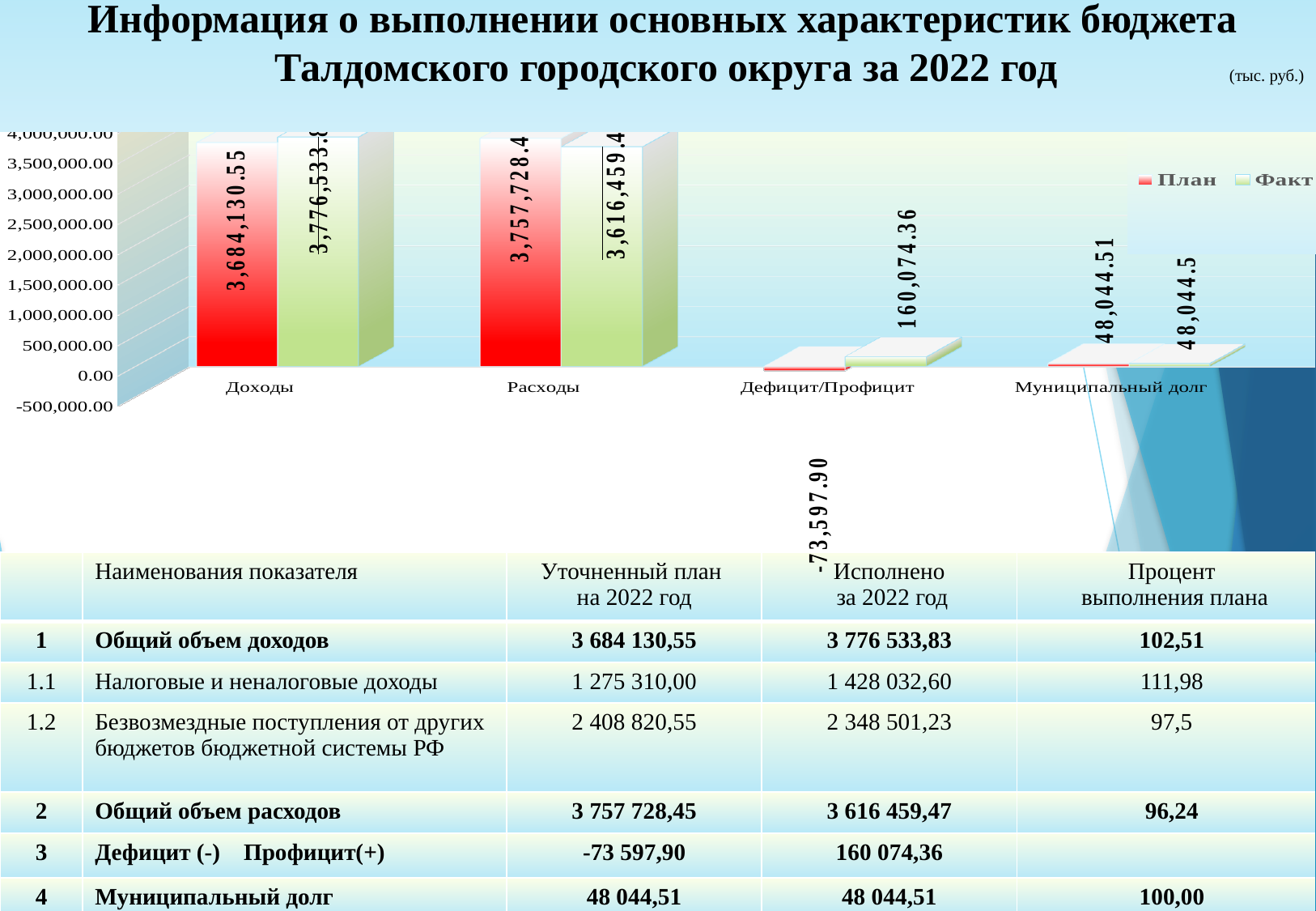
What is the difference between the Факт and План values for Дефицит/Профицит? 233,672.26 What kind of chart is shown on the slide? bar chart What is the План value for Дефицит/Профицит? -73,597.90 Which category has the lowest value in the chart? Дефицит/Профицит (План) How many series does the legend list? 2 What is the Факт value for Дефицит/Профицит? 160,074.36 What is the План value for Доходы? 3,684,130.55 Which is larger: the План value for Доходы or the План value for Расходы? Расходы How many categories are shown on the x axis of the chart? 4 Is the Факт value for Доходы greater or less than 3,500,000.00? greater Which is larger: the Факт value for Доходы or the Факт value for Расходы? Доходы What is the План value for Муниципальный долг? 48,044.51